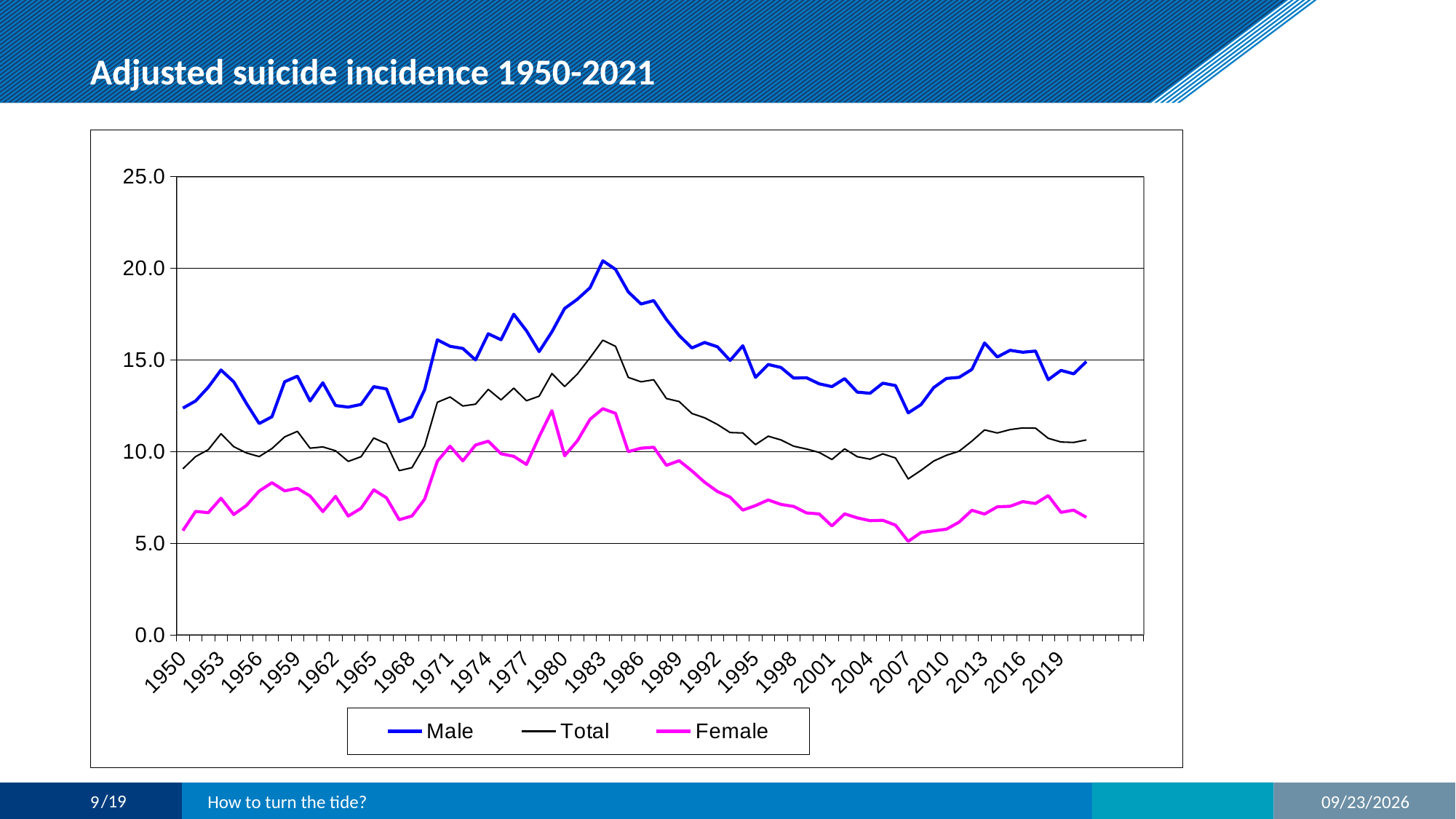
What is the title of the chart? Adjusted suicide incidence 1950-2021 Is the value for Female in 1983 greater or less than 10.0? greater Is the value for Female in 2007 greater or less than 10.0? less Which series has the lowest values across the whole period? Female Is the value for Total in 1950 greater or less than 10.0? less How many series does the legend list? 3 What are the series named in the legend? Male, Total, Female Does the Male series rise or fall between 1983 and 2007? fall Which series has the highest values across the whole period? Male In 1983, which is larger, the Male value or the Female value? Male What kind of chart is shown on the slide? line chart